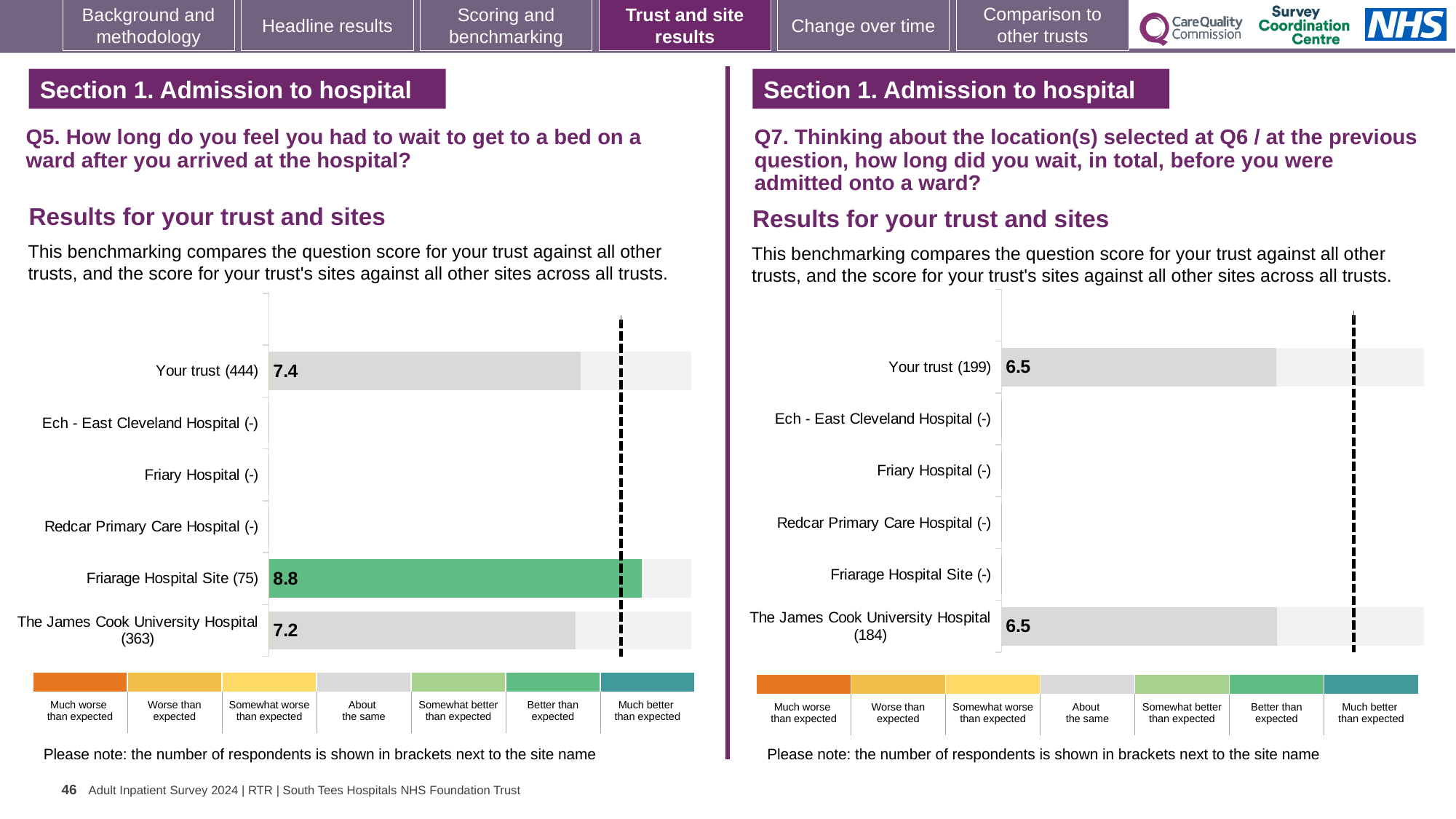
On the Q7 chart (right), what is the score for The James Cook University Hospital? 6.5 What kind of chart is used on the Q5 chart (left)? Bar chart On the Q5 chart (left), what is the score for Friarage Hospital Site? 8.8 On the Q5 chart (left), what is the difference between the Friarage Hospital Site score and The James Cook University Hospital score? 1.6 On the Q5 chart (left), what is the score for Your trust? 7.4 On the Q7 chart (right), how many category labels are listed on the vertical axis? 6 On the Q5 chart (left), which has the larger score, Your trust or The James Cook University Hospital? Your trust On the Q5 chart (left), what is the score for The James Cook University Hospital? 7.2 On the Q5 chart (left), how many respondents are shown for Friarage Hospital Site? 75 On the Q5 chart (left), which site has the highest score? Friarage Hospital Site On the Q7 chart (right), what is the score for Your trust? 6.5 On the Q7 chart (right), how many respondents are shown for Your trust? 199